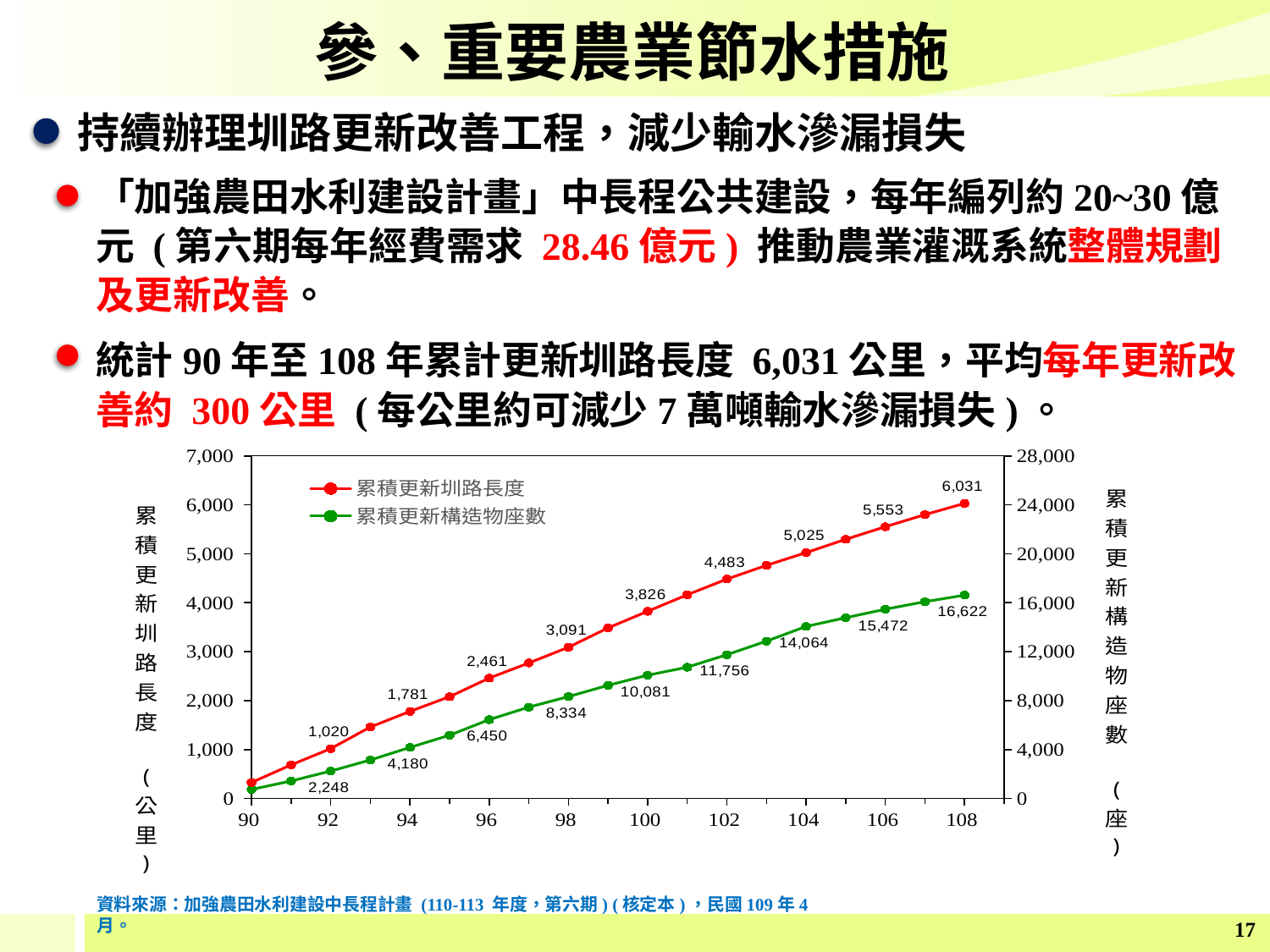
What is the maximum value shown on the right-hand vertical axis? 28,000 Is the value of 累積更新圳路長度 at year 104 greater or less than 5,000? greater Which series is drawn in red? 累積更新圳路長度 How many series does the chart legend list? 2 What is the value of 累積更新圳路長度 at year 96? 2,461 Does the 累積更新圳路長度 series rise or fall from year 90 to year 108? rise What is the value of 累積更新構造物座數 at year 92? 2,248 What is the difference between the 累積更新構造物座數 values at year 104 and year 102? 2,308 What is the value of 累積更新圳路長度 at year 108? 6,031 What type of chart is shown on the slide? line chart By how much did 累積更新圳路長度 increase from year 106 to year 108? 478 What is the value of 累積更新構造物座數 at year 100? 10,081